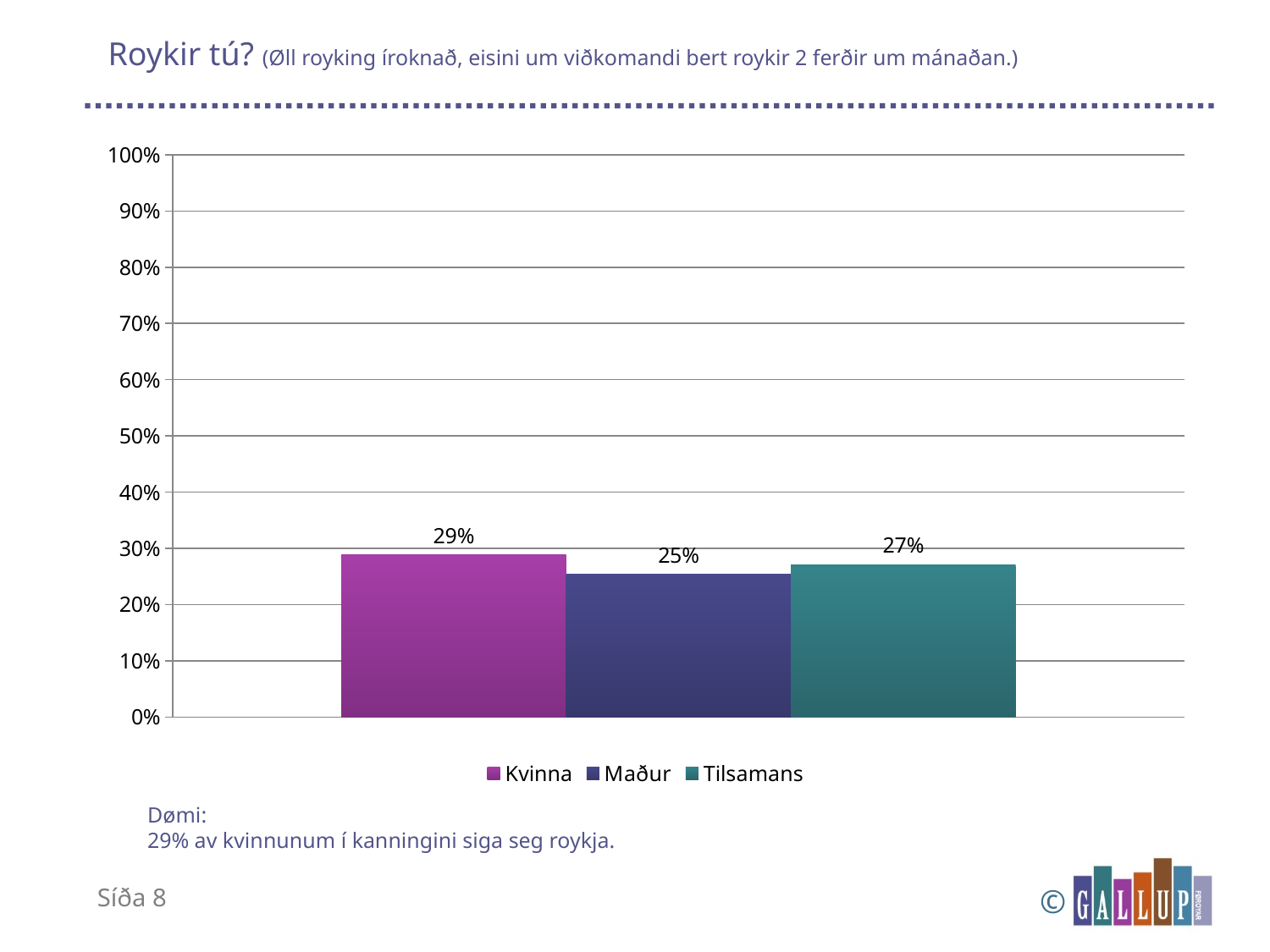
How many series does the legend list? 3 What kind of chart is shown on the slide? bar chart Is the value for Maður greater or less than 30%? less What is the value for Kvinna? 29% What colour is the bar for Tilsamans? teal What is the difference between the values for Tilsamans and Maður? 2% Which series has the highest value? Kvinna Which is larger, the value for Kvinna or the value for Tilsamans? Kvinna Which series has the lowest value? Maður What is the difference between the values for Kvinna and Maður? 4% What is the value for Maður? 25% What is the value for Tilsamans? 27%